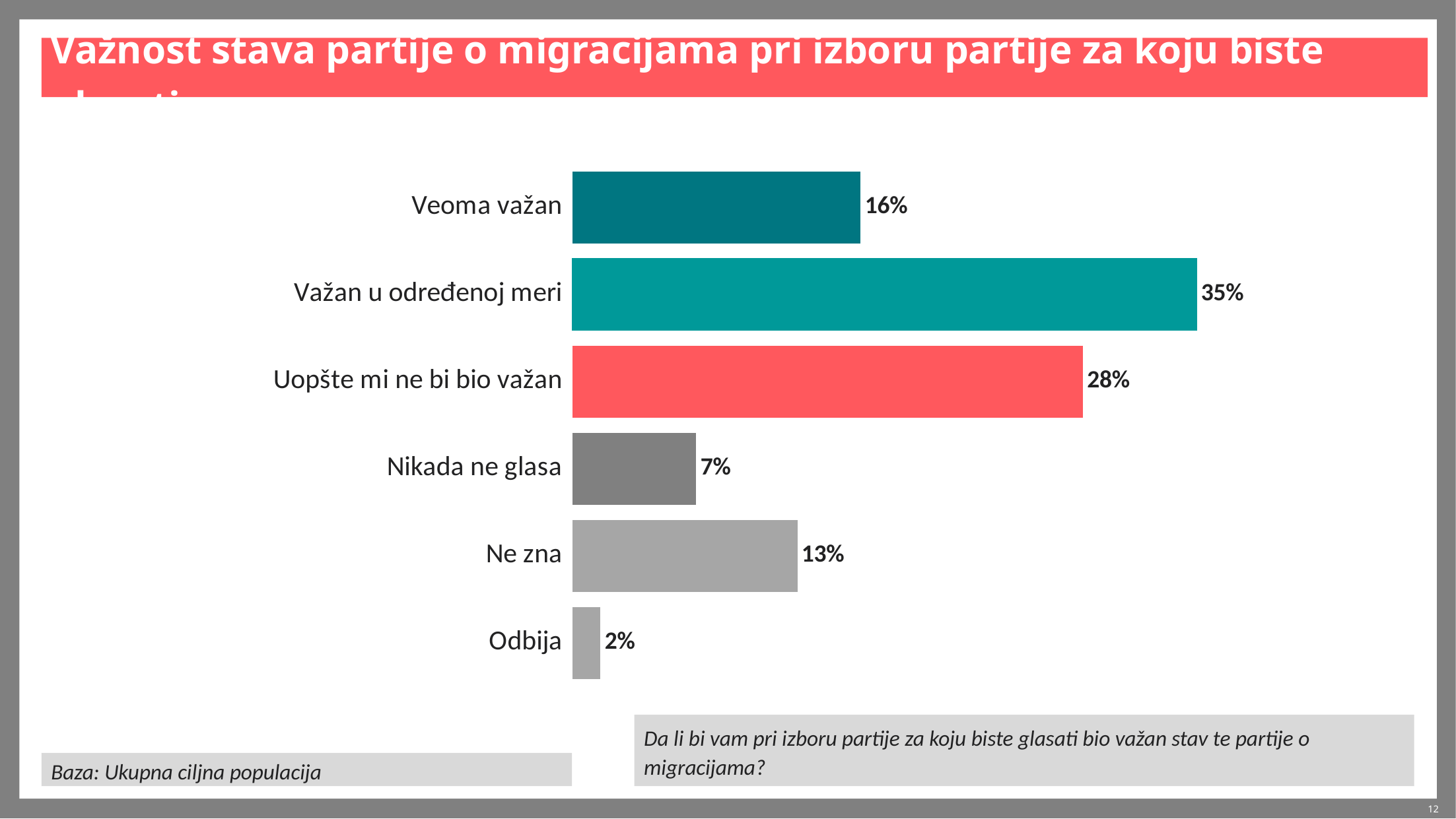
What is the value for "Važan u određenoj meri"? 35% Which category has the lowest value? Odbija What colour is the bar for "Uopšte mi ne bi bio važan"? Red What is the difference between the values for "Važan u određenoj meri" and "Uopšte mi ne bi bio važan"? 7% How many categories are shown in the chart? 6 Which category has the highest value? Važan u određenoj meri What kind of chart is shown on the slide? Bar chart Which is larger, the value for "Veoma važan" or the value for "Ne zna"? Veoma važan What is the value for "Ne zna"? 13% What is the value for "Veoma važan"? 16% What is the value for "Nikada ne glasa"? 7% What is the value for "Uopšte mi ne bi bio važan"? 28%